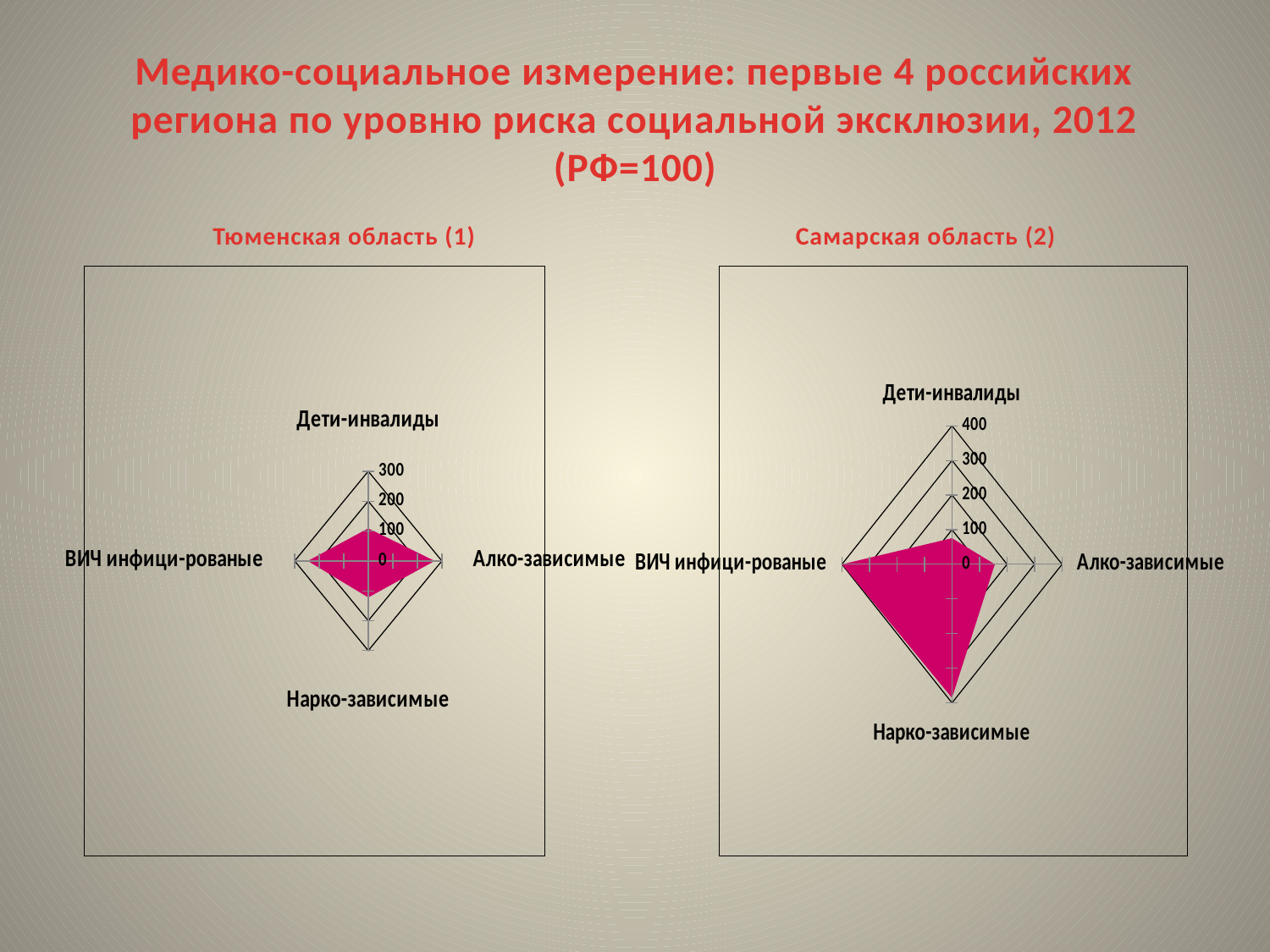
On the Самарская область (2) chart, which is larger, Нарко-зависимые or Алко-зависимые? Нарко-зависимые What kind of chart is used for Тюменская область (1)? Radar chart On the Тюменская область (1) chart, is the value for Алко-зависимые greater or less than 100? greater On the Тюменская область (1) chart, is the value for Нарко-зависимые greater or less than 200? less On the Самарская область (2) chart, is the value for Нарко-зависимые greater or less than 300? greater What is the highest axis value shown on the Самарская область (2) chart? 400 On the Тюменская область (1) chart, which is larger, Алко-зависимые or Дети-инвалиды? Алко-зависимые What is the highest axis value shown on the Тюменская область (1) chart? 300 How many categories are plotted on the Самарская область (2) chart? 4